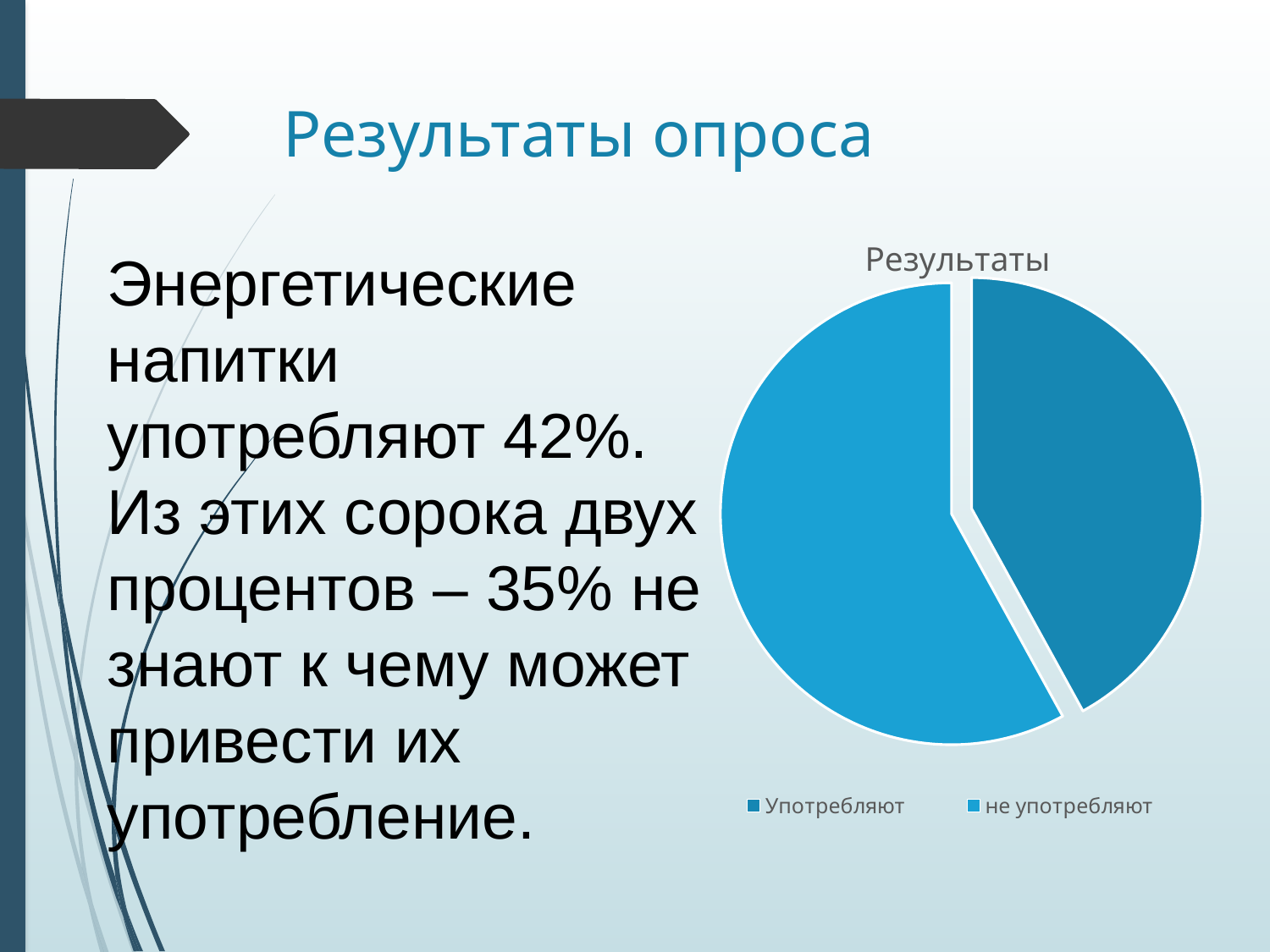
Which slice of the pie chart is the largest? не употребляют Which slice is larger, "Употребляют" or "не употребляют"? не употребляют Which slice of the pie chart is the smallest? Употребляют Which slice of the pie chart is pulled out (exploded) from the rest of the pie? Употребляют What is the title of the chart? Результаты How many entries does the chart legend list? 2 How many slices does the pie chart have? 2 What kind of chart is shown on the slide? pie chart